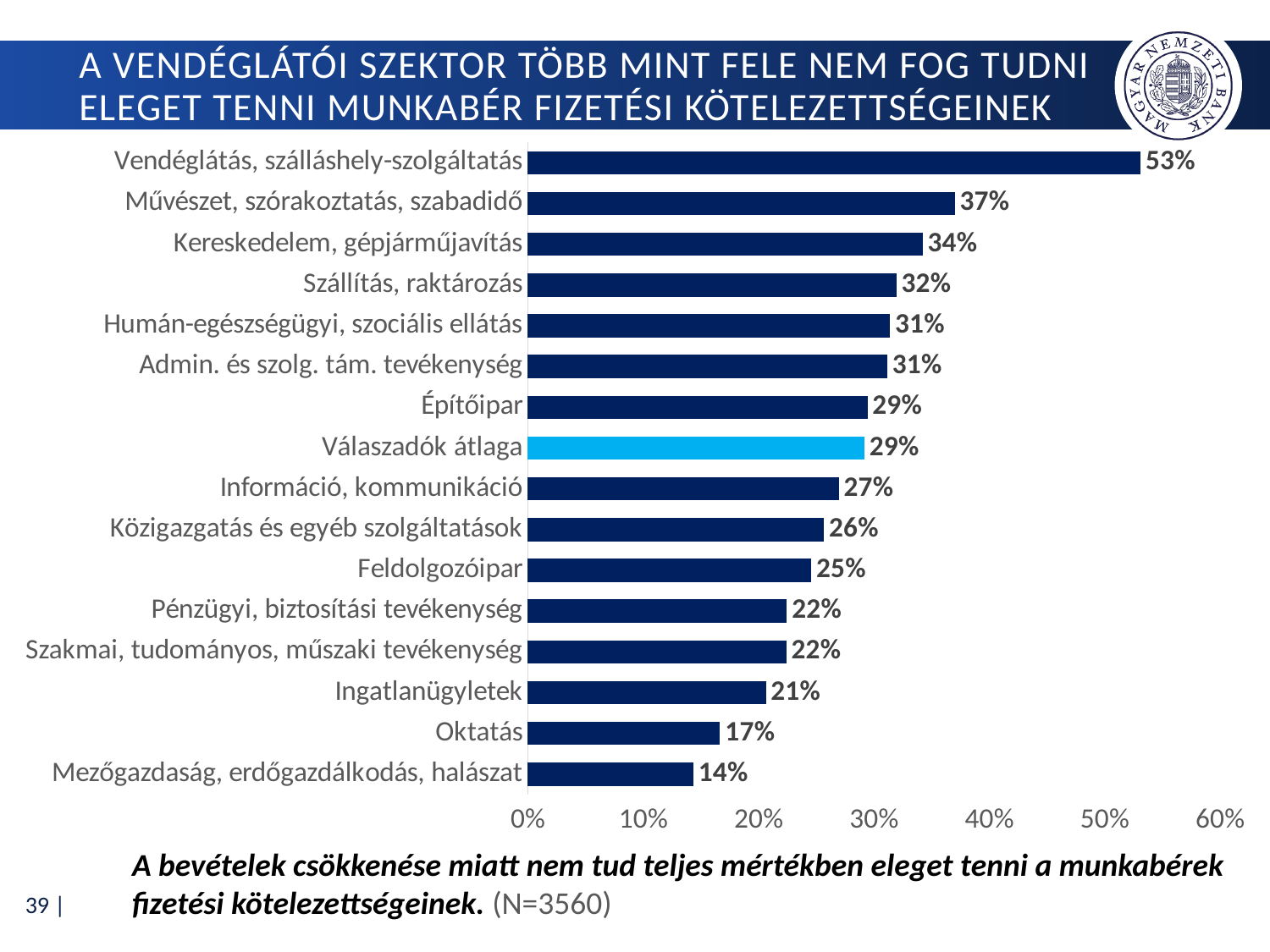
How many categories are shown in the chart? 16 What kind of chart is shown on the slide? Bar chart Which category has the lowest value? Mezőgazdaság, erdőgazdálkodás, halászat Which bar is shown in a different (light blue) colour from the others? Válaszadók átlaga What is the value for Oktatás? 17% What is the difference between the values for Kereskedelem, gépjárműjavítás and Válaszadók átlaga? 5% Is the value for Művészet, szórakoztatás, szabadidő greater or less than 30%? greater What is the value for Vendéglátás, szálláshely-szolgáltatás? 53% What is the value for Válaszadók átlaga? 29% What is the difference between the values for Vendéglátás, szálláshely-szolgáltatás and Mezőgazdaság, erdőgazdálkodás, halászat? 39% Which category has the highest value? Vendéglátás, szálláshely-szolgáltatás Which is larger, the value for Feldolgozóipar or the value for Ingatlanügyletek? Feldolgozóipar